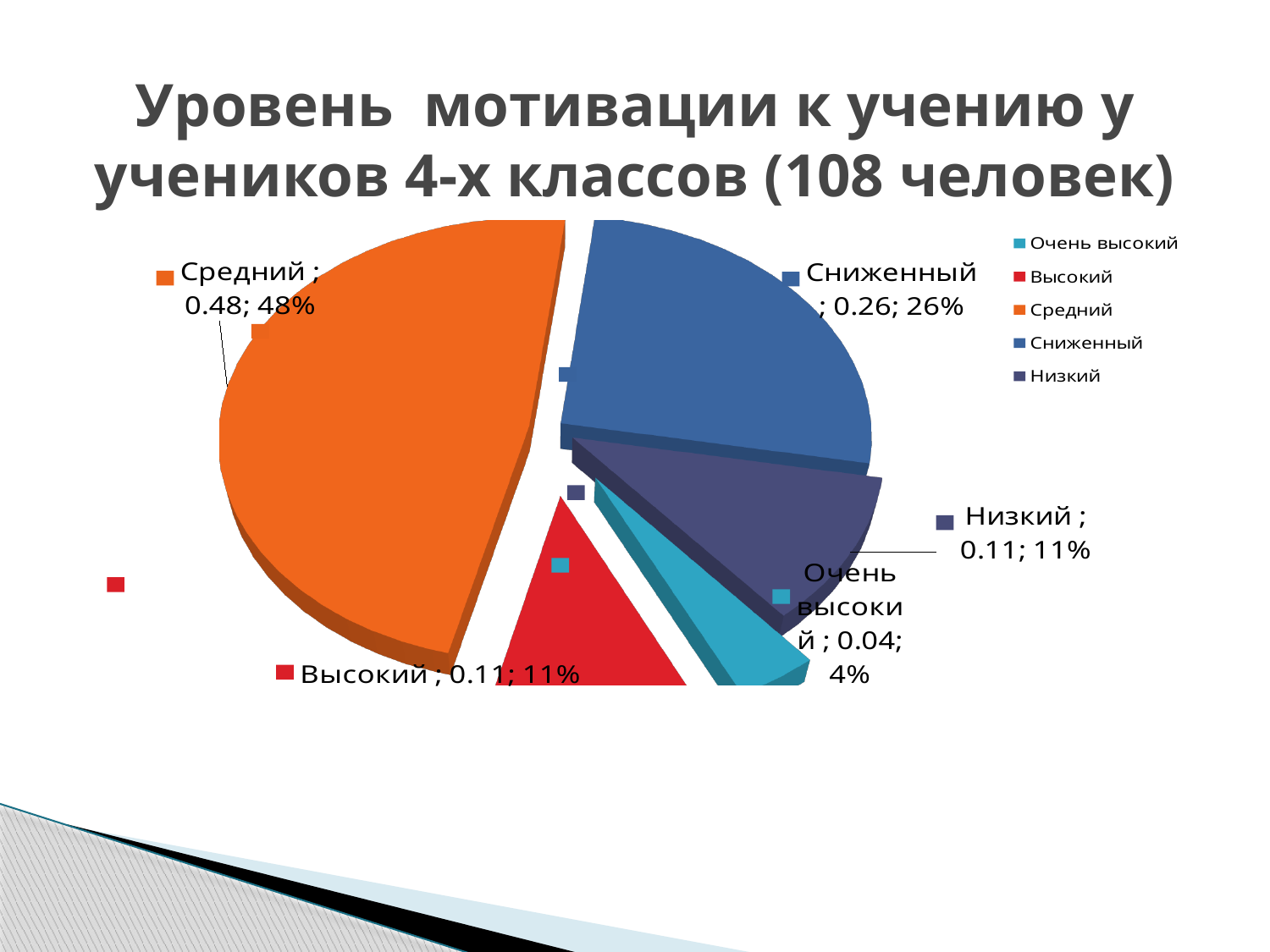
How many categories does the pie chart have? 5 What share of the pie does the "Средний" slice represent? 48% What is the title of the chart on the slide? Уровень мотивации к учению у учеников 4-х классов (108 человек) What value is printed for the "Высокий" slice? 0.11 What share of the pie does the "Сниженный" slice represent? 26% What is the difference in percentage points between the "Средний" and "Сниженный" slices? 22% Which category has the largest slice of the pie? Средний Which slice is larger, "Сниженный" or "Низкий"? Сниженный Which category has the smallest slice of the pie? Очень высокий What kind of chart is shown on the slide? pie chart What share of the pie does the "Очень высокий" slice represent? 4%